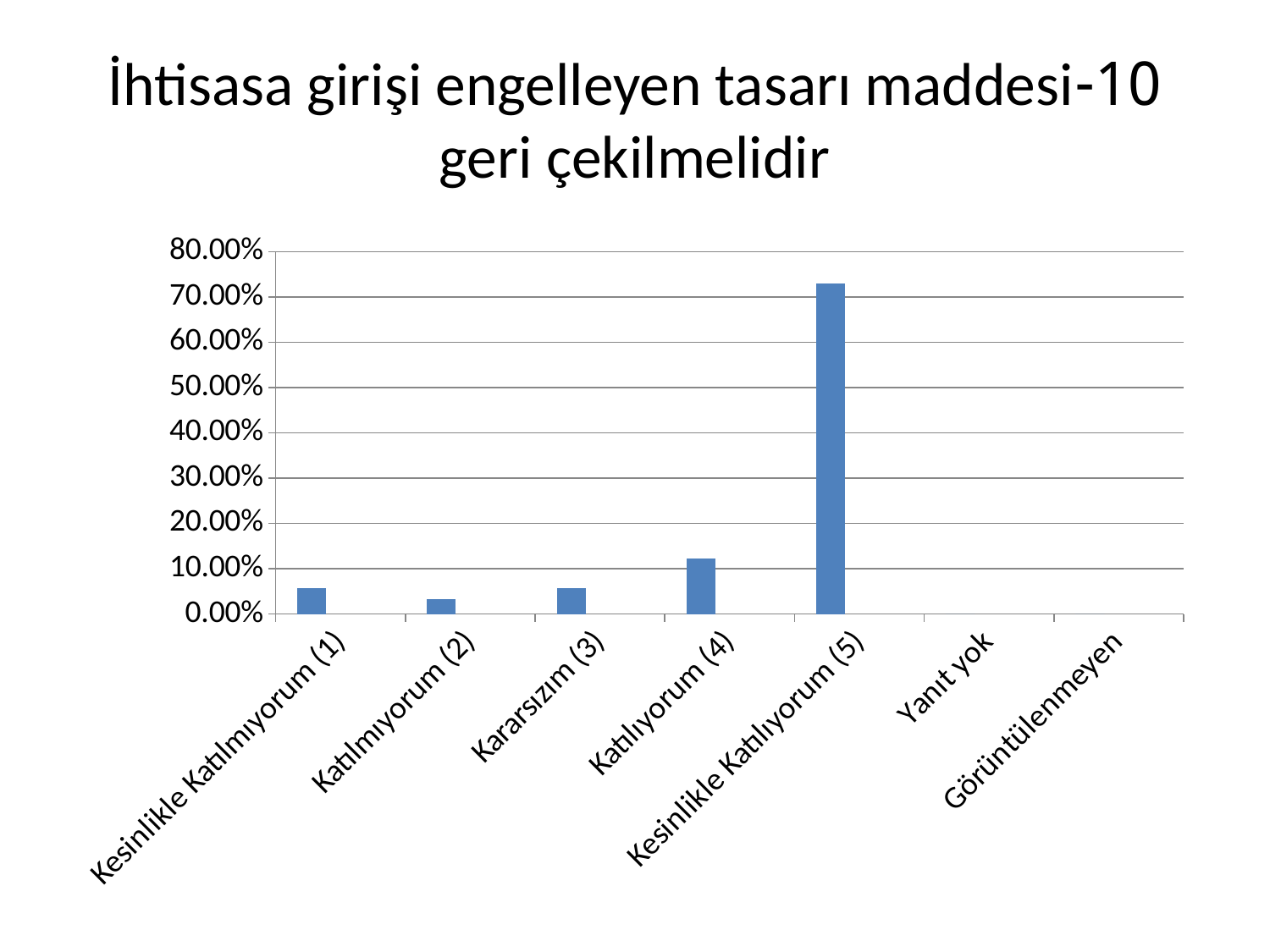
Is the value for Katılmıyorum (2) greater or less than 10.00%? less Which is larger, the value for Katılıyorum (4) or the value for Katılmıyorum (2)? Katılıyorum (4) Is the value for Kararsızım (3) greater or less than 10.00%? less What is the title of the chart on the slide? İhtisasa girişi engelleyen tasarı maddesi-10 geri çekilmelidir Which category has the highest value in the chart? Kesinlikle Katılıyorum (5) How many categories are shown on the x axis of the chart? 7 Is the value for Kesinlikle Katılıyorum (5) greater or less than 70.00%? greater Which is larger, the value for Kesinlikle Katılıyorum (5) or the value for Katılıyorum (4)? Kesinlikle Katılıyorum (5) What kind of chart is shown on the slide? bar chart What is the highest value shown on the y axis of the chart? 80.00%